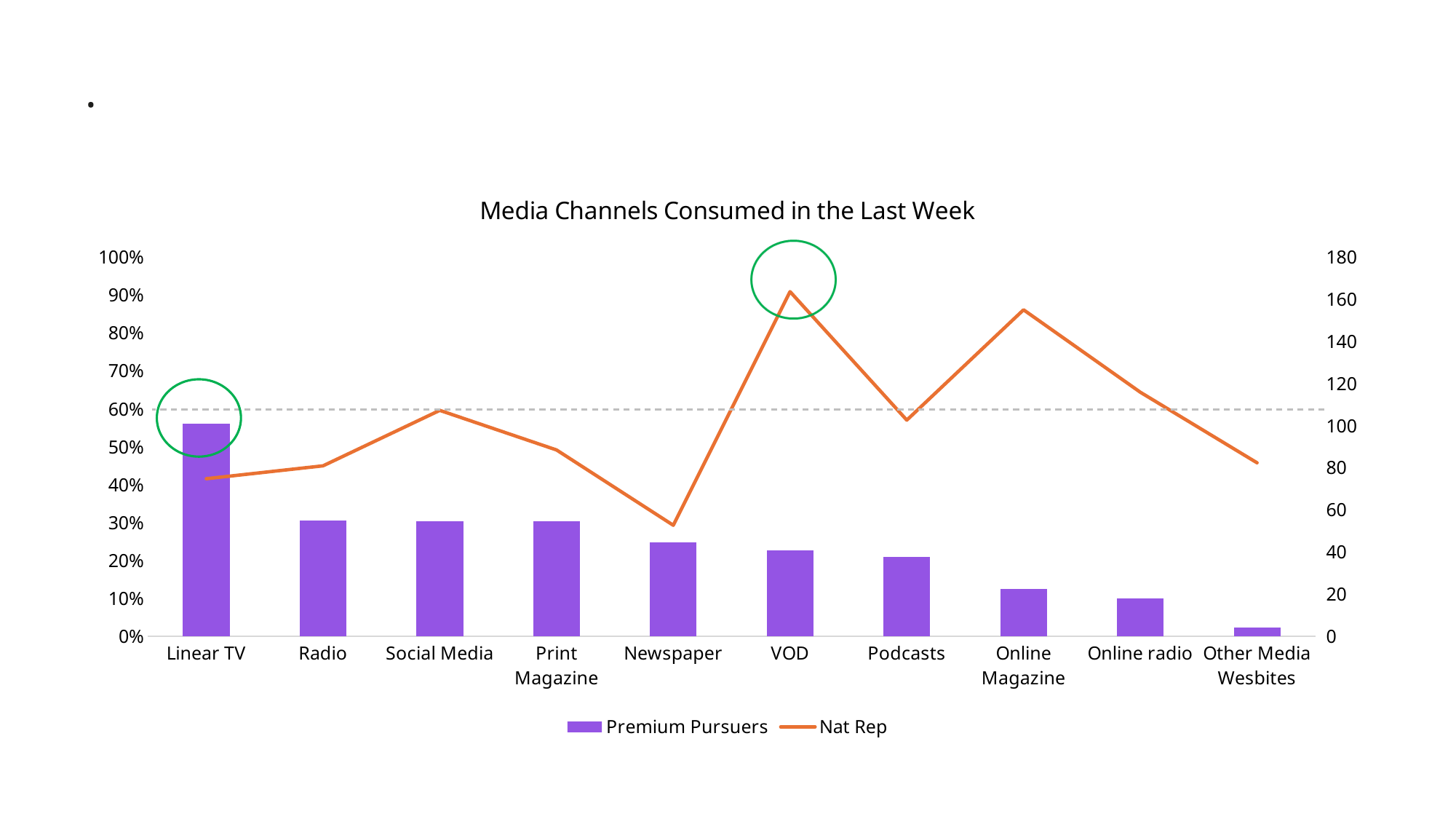
How many series does the legend list? 2 What is the title of the chart? Media Channels Consumed in the Last Week Is the Nat Rep value for Online Magazine greater or less than 140? greater How many media channel categories are shown on the x axis? 10 At which media channel does the Nat Rep line reach its lowest point? Newspaper What are the two series named in the legend? Premium Pursuers and Nat Rep At which media channel does the Nat Rep line reach its highest point? VOD Which has the larger Premium Pursuers bar, Newspaper or Online Magazine? Newspaper Which media channel has the highest Premium Pursuers bar? Linear TV Is the Premium Pursuers value for Online radio greater or less than 20%? less Is the Premium Pursuers value for Linear TV greater or less than 50%? greater Which media channel has the lowest Premium Pursuers bar? Other Media Wesbites